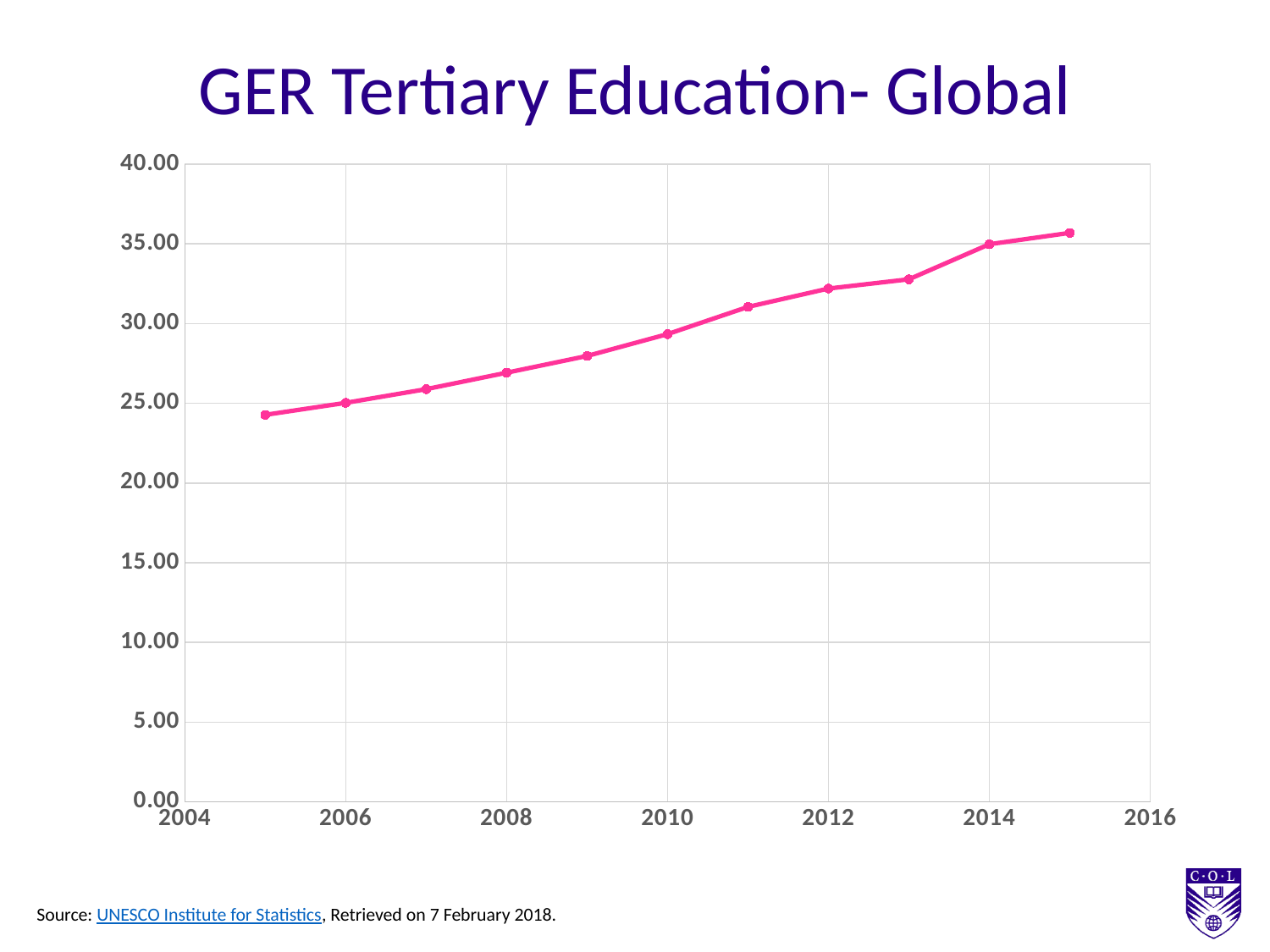
What is the title of the chart? GER Tertiary Education- Global How many data points are plotted on the line? 11 Which year has the highest value? 2015 Is the value for 2012 greater or less than 35.00? less What colour is the plotted line? pink What kind of chart is shown on the slide? line chart Do the values rise or fall from 2005 to 2015? rise Is the value for 2005 greater or less than 25.00? less Is the value for 2011 greater or less than 30.00? greater Which year has the lowest value? 2005 Which is larger, the value for 2014 or the value for 2010? 2014